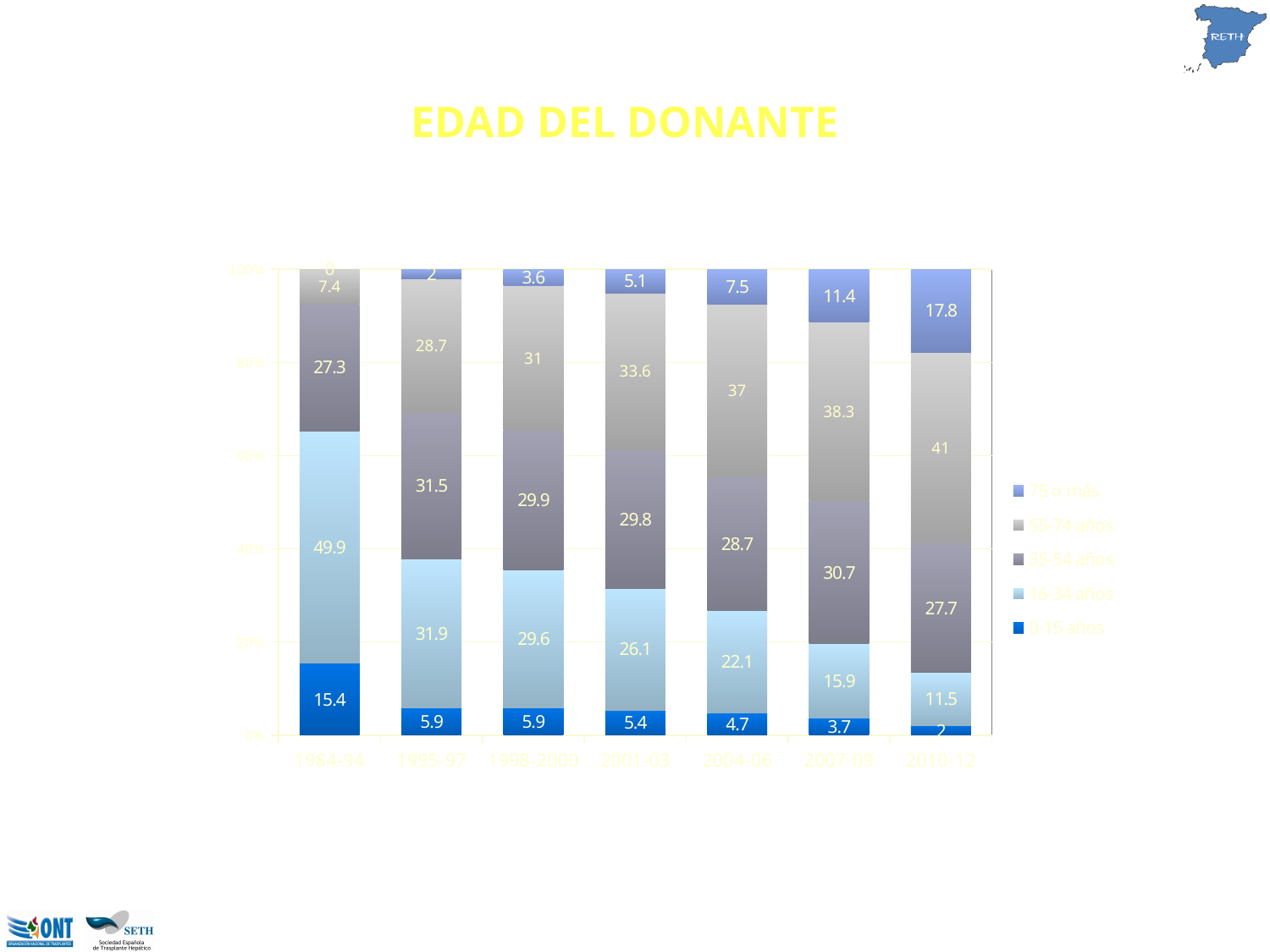
What is the value for the 75 o más series in 2010-12? 17.8 What is the value for the 16-34 años series in 1984-94? 49.9 How many series does the legend list? 5 Does the 75 o más value rise or fall from 1984-94 to 2010-12? Rise In which period is the 55-74 años value highest? 2010-12 What is the title of the chart? EDAD DEL DONANTE What kind of chart is shown on the slide? Stacked bar chart In which period is the 0-15 años value lowest? 2010-12 How many periods are shown on the x axis? 7 Which is larger in 2007-09: the 35-54 años value or the 16-34 años value? 35-54 años What is the value for the 0-15 años series in 2004-06? 4.7 What is the difference between the 55-74 años values in 2010-12 and 1984-94? 33.6